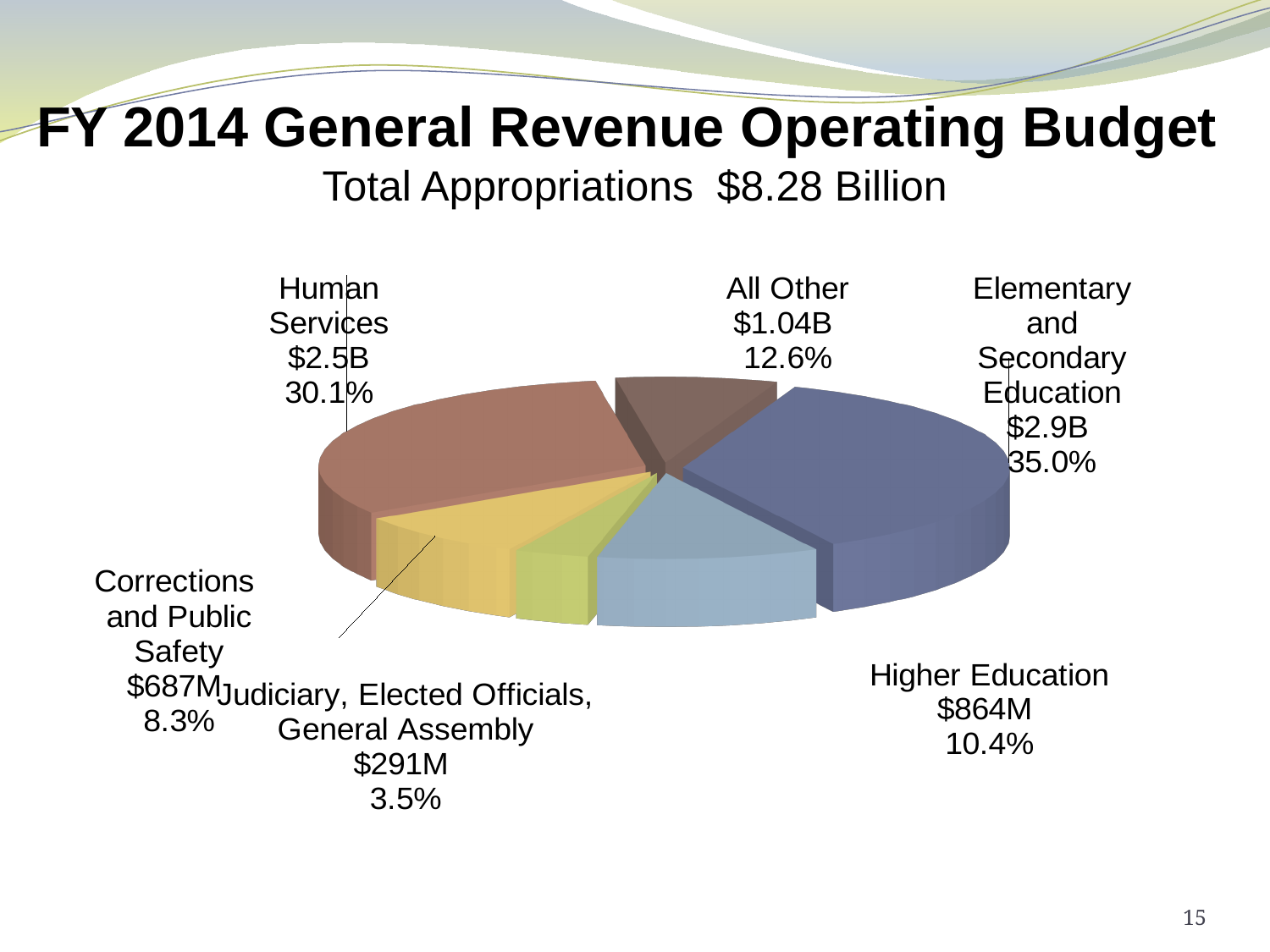
What kind of chart is shown on the slide? Pie chart Which category has the smallest share of the budget? Judiciary, Elected Officials, General Assembly What total appropriations amount is stated in the chart subtitle? $8.28 Billion What is the dollar amount for All Other? $1.04B Which is larger, the share for All Other or the share for Higher Education? All Other Which category has the largest share of the budget? Elementary and Secondary Education What share of the budget is Higher Education? 10.4% What share of the budget goes to Elementary and Secondary Education? 35.0% What is the dollar amount for Corrections and Public Safety? $687M What is the dollar amount for Human Services? $2.5B What is the difference in percentage points between Elementary and Secondary Education and Human Services? 4.9 How many slices does the pie chart have? 6